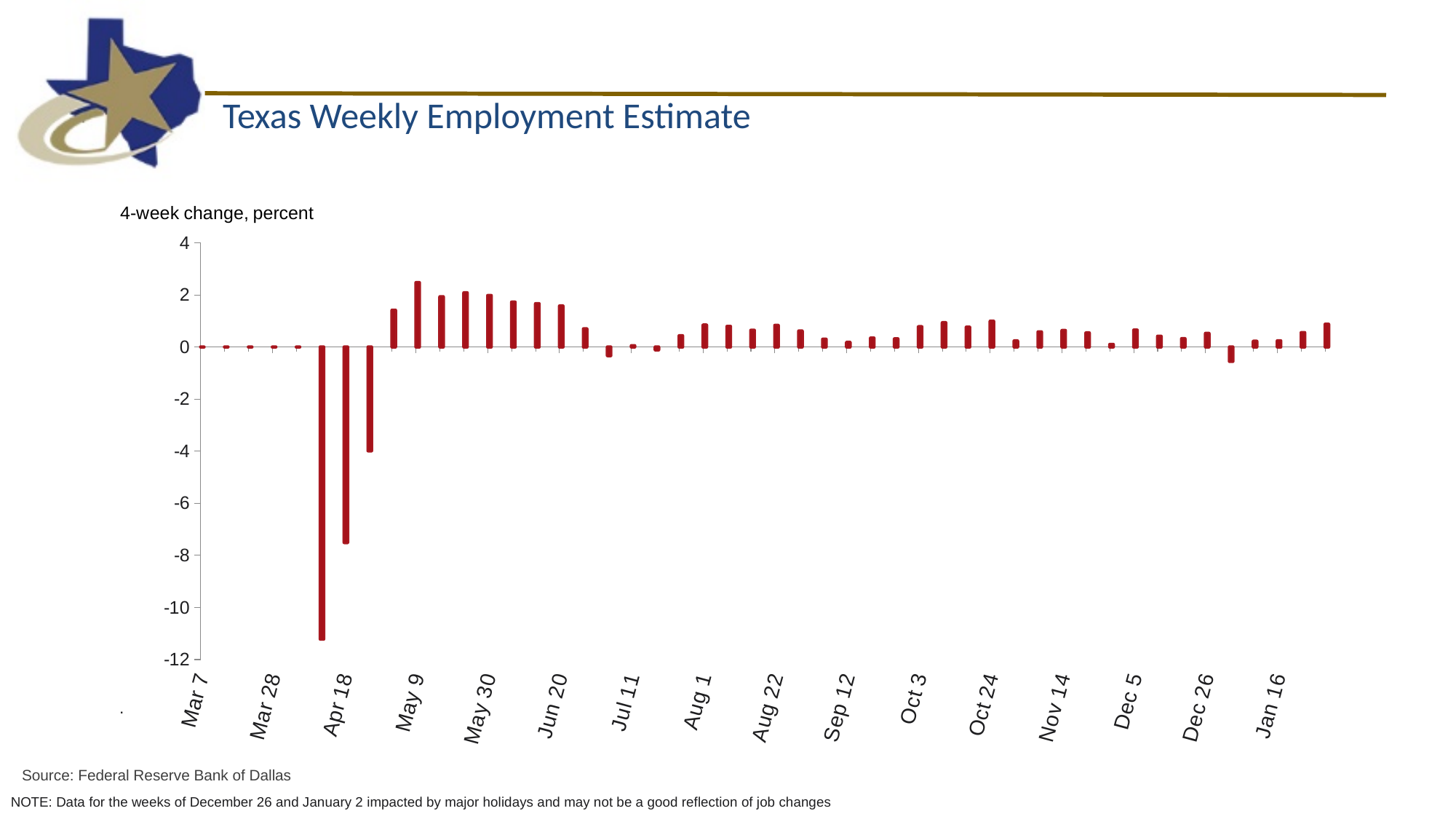
Which of the two is larger, the value for May 9 or the value for Apr 18? May 9 Is the value for May 9 greater or less than 0? greater Is the value for Apr 18 greater or less than -2? less Is the lowest value in the chart greater or less than -10? less What unit or measure does the chart's axis label say the values are in? 4-week change, percent How many date labels are shown along the x axis of the chart? 16 What is the highest value shown on the y axis of the chart? 4 What kind of chart is shown on the slide? bar chart What is the title of the chart on the slide? Texas Weekly Employment Estimate